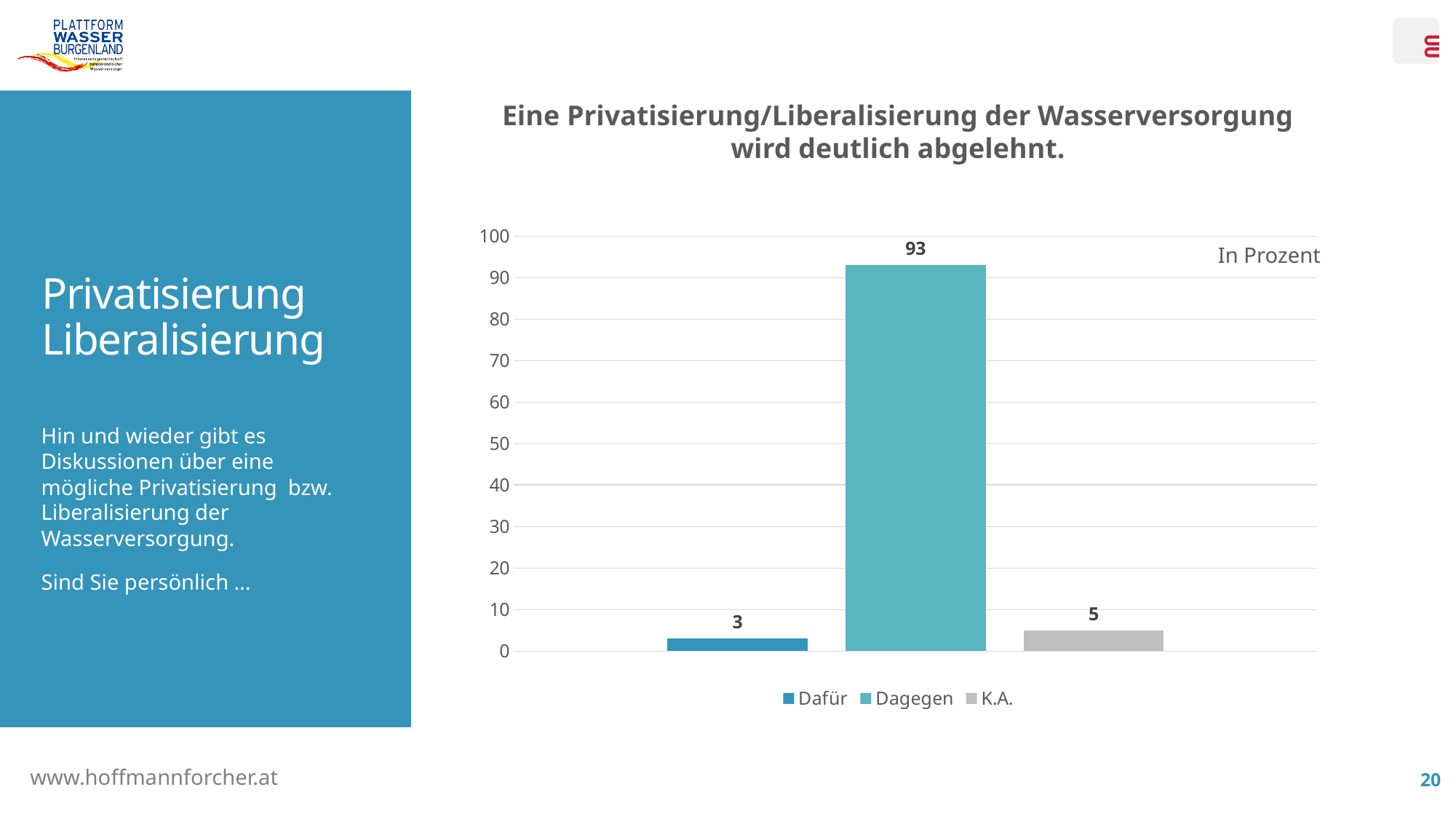
What is the value for Dagegen? 93 What is the difference between the values for K.A. and Dafür? 2 What is the difference between the values for Dagegen and Dafür? 90 How many series does the legend list? 3 What unit does the chart state its values are in? In Prozent Which is larger, the value for K.A. or the value for Dafür? K.A. What is the value for K.A.? 5 Which category has the lowest value? Dafür Which category has the highest value? Dagegen Is the value for Dagegen greater or less than 90? greater What kind of chart is shown on the slide? bar chart What is the value for Dafür? 3